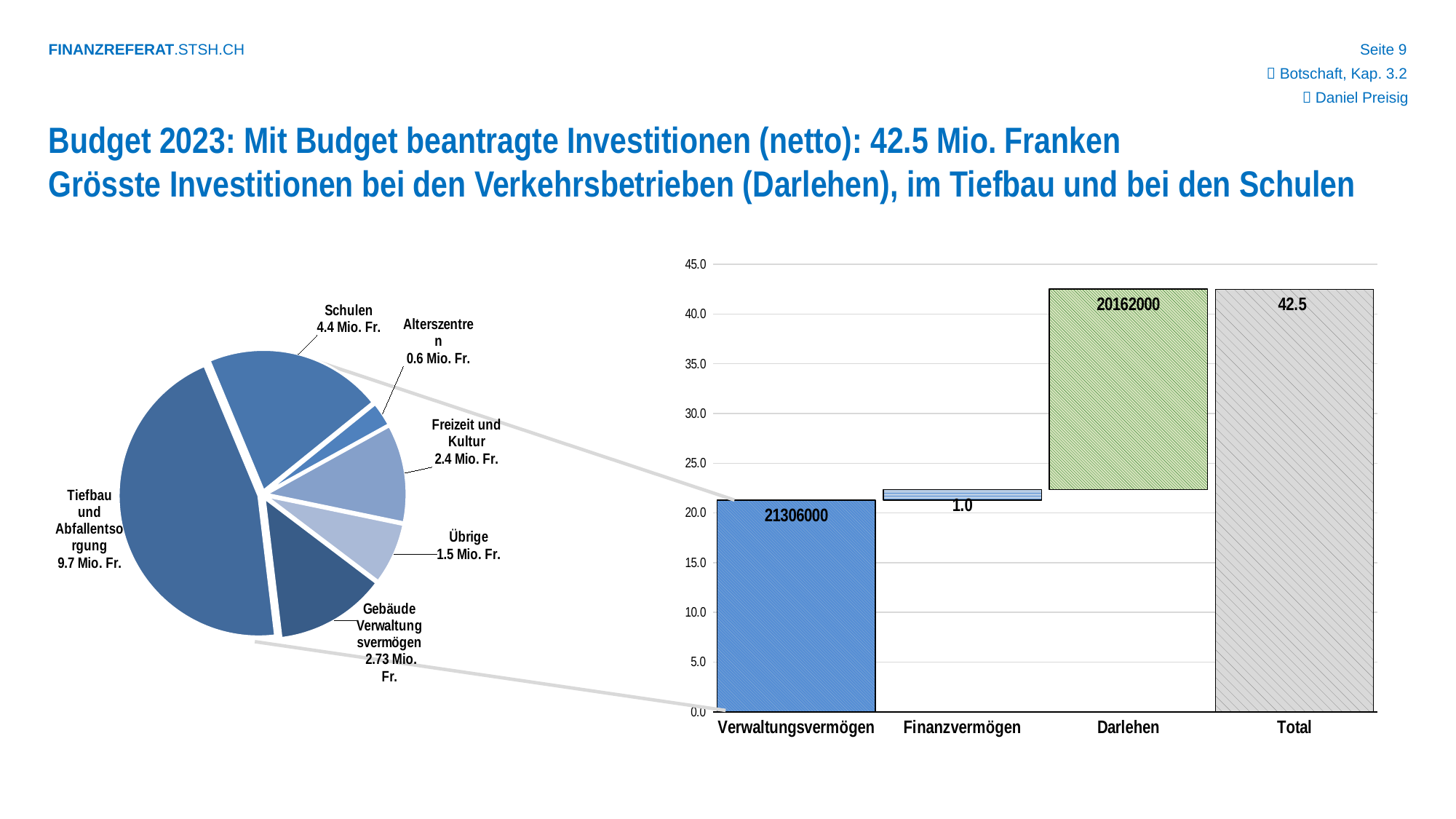
What kind of chart is the chart on the right of the slide? bar chart How many slices does the pie chart on the left have? 6 How many categories are shown on the x axis of the bar chart on the right? 4 In the pie chart on the left, which is larger: Übrige or Gebäude Verwaltungsvermögen? Gebäude Verwaltungsvermögen In the pie chart on the left, which category has the largest slice? Tiefbau und Abfallentsorgung In the pie chart on the left, which category has the smallest slice? Alterszentren In the pie chart on the left, what is the difference between the values for Schulen and Freizeit und Kultur? 2.0 Mio. Fr. In the pie chart on the left, what is the value for Tiefbau und Abfallentsorgung? 9.7 Mio. Fr. In the bar chart on the right, what value is labelled on the Total bar? 42.5 In the bar chart on the right, what value is labelled on the Darlehen bar? 20162000 In the pie chart on the left, what is the value for Schulen? 4.4 Mio. Fr. In the bar chart on the right, is the top of the Verwaltungsvermögen bar greater or less than 20.0? greater